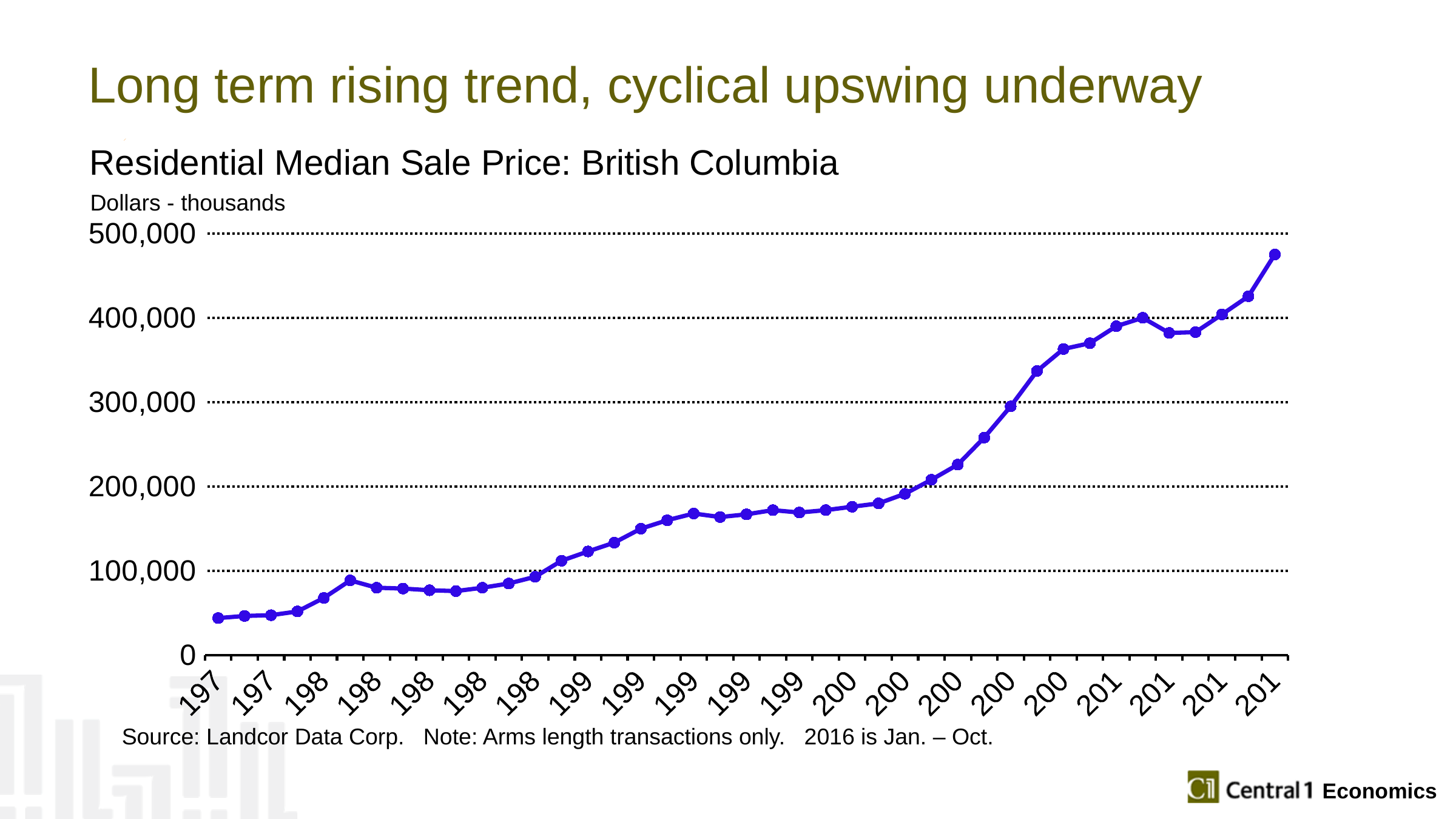
What is the highest value shown on the vertical axis? 500,000 What is the title of the chart? Residential Median Sale Price: British Columbia What unit label is shown above the vertical axis? Dollars - thousands Which point on the line is the highest? the last (rightmost) point, 2016 Is the value for the point at the middle of the chart (around the 21st point) greater or less than 200,000? less Which is larger, the value at the first (leftmost) point or the value at the last (rightmost) point? the last (rightmost) point Which point on the line is the lowest? the first (leftmost) point Is the value for the first (leftmost) point greater or less than 100,000? less What kind of chart is shown on the slide? line chart Overall, do the values rise or fall from left to right along the x axis? rise Is the value for the last (rightmost) point greater or less than 400,000? greater